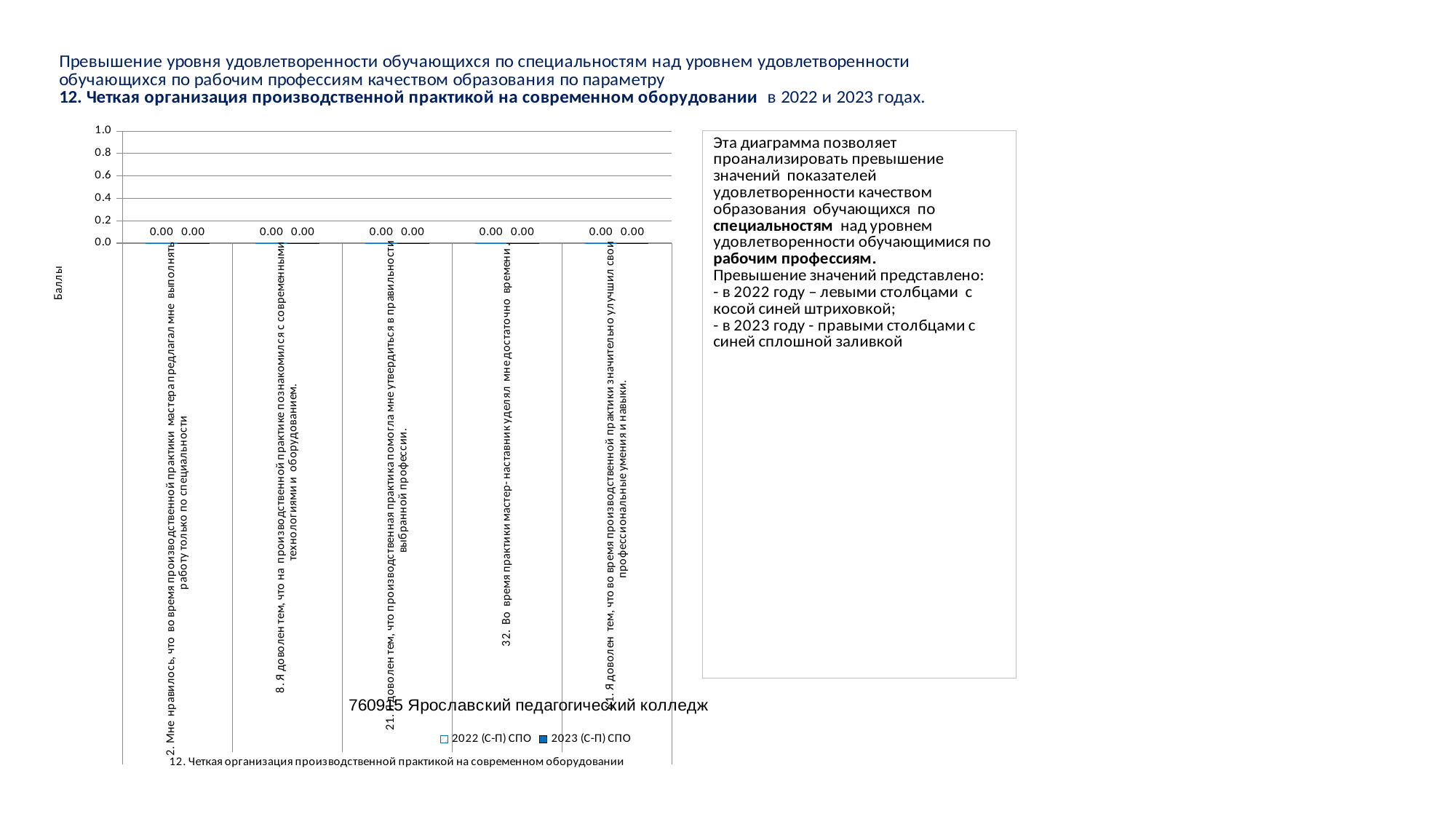
How many categories are plotted along the x axis of the chart? 5 What is the highest tick value shown on the vertical axis of the chart? 1.0 What is the value of the 2023 (С-П) СПО series for category 32 (Во время практики мастер-наставник уделял мне достаточно времени)? 0.00 What kind of chart is shown on the slide? bar chart What is the difference between the 2022 (С-П) СПО and 2023 (С-П) СПО values for category 21 (Доволен тем, что производственная практика помогла мне утвердиться в правильности выбранной профессии)? 0.00 How many series does the chart legend list? 2 What is the label of the vertical axis of the chart? Баллы What is the value of the 2022 (С-П) СПО series for category 8 (Я доволен тем, что на производственной практике познакомился с современными технологиями и оборудованием)? 0.00 Is the value of the 2023 (С-П) СПО series for category 2 greater or less than 0.2? less What are the two legend entries of the chart? 2022 (С-П) СПО and 2023 (С-П) СПО